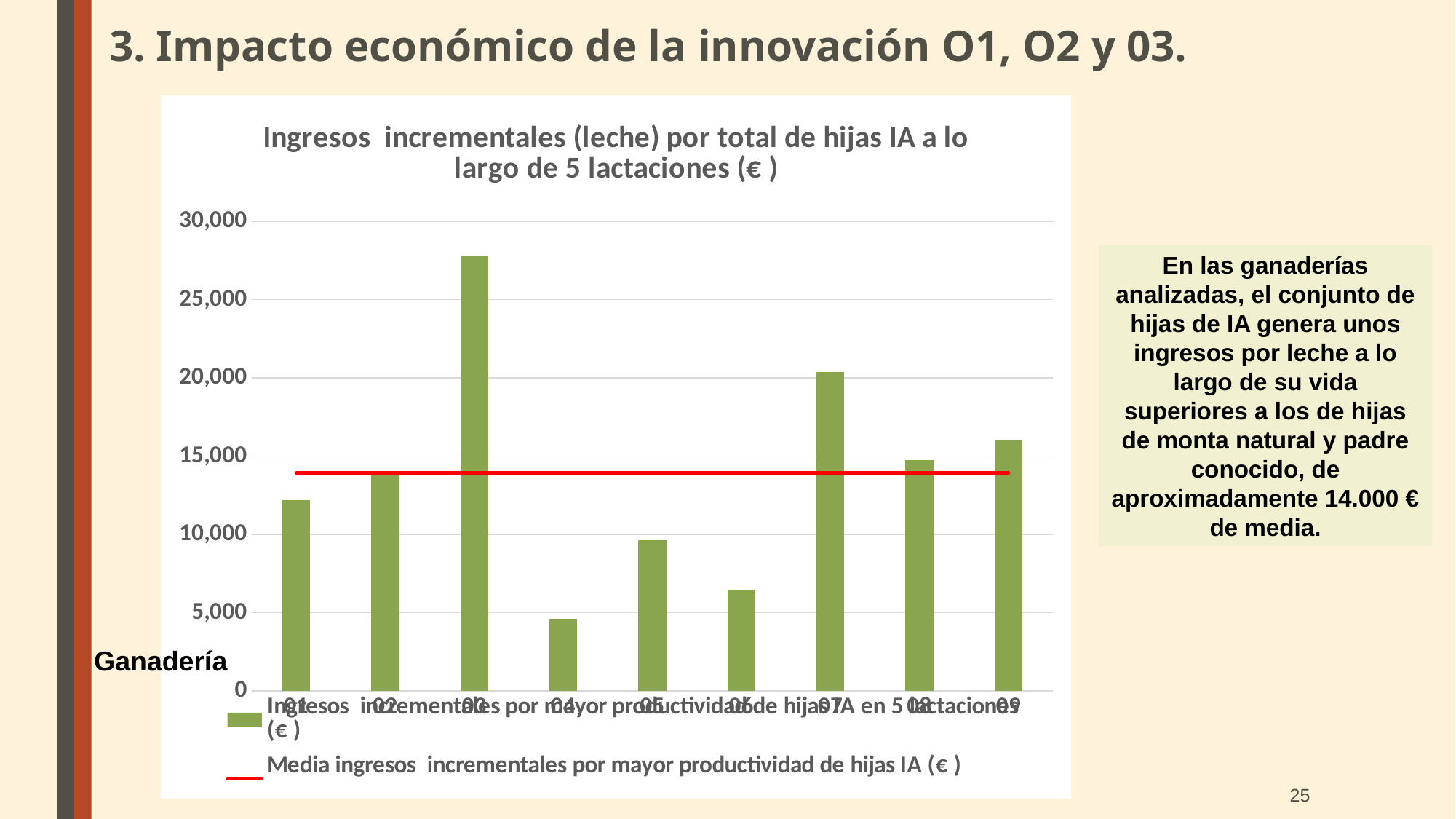
Is the value for ganadería 07 greater or less than 15,000? greater Is the value for ganadería 03 greater or less than 25,000? greater Which ganadería has the lowest ingresos incrementales? 04 Which has a larger value, ganadería 05 or ganadería 06? 05 What kind of chart is shown on the slide? combination bar and line chart How many ganaderías (categories) are plotted on the x axis? 9 Is the value for ganadería 04 greater or less than 5,000? less How many series does the legend list? 2 Which has a larger value, ganadería 03 or ganadería 07? 03 Which ganadería has the highest ingresos incrementales? 03 What colour is the line representing the media (mean) ingresos incrementales? red